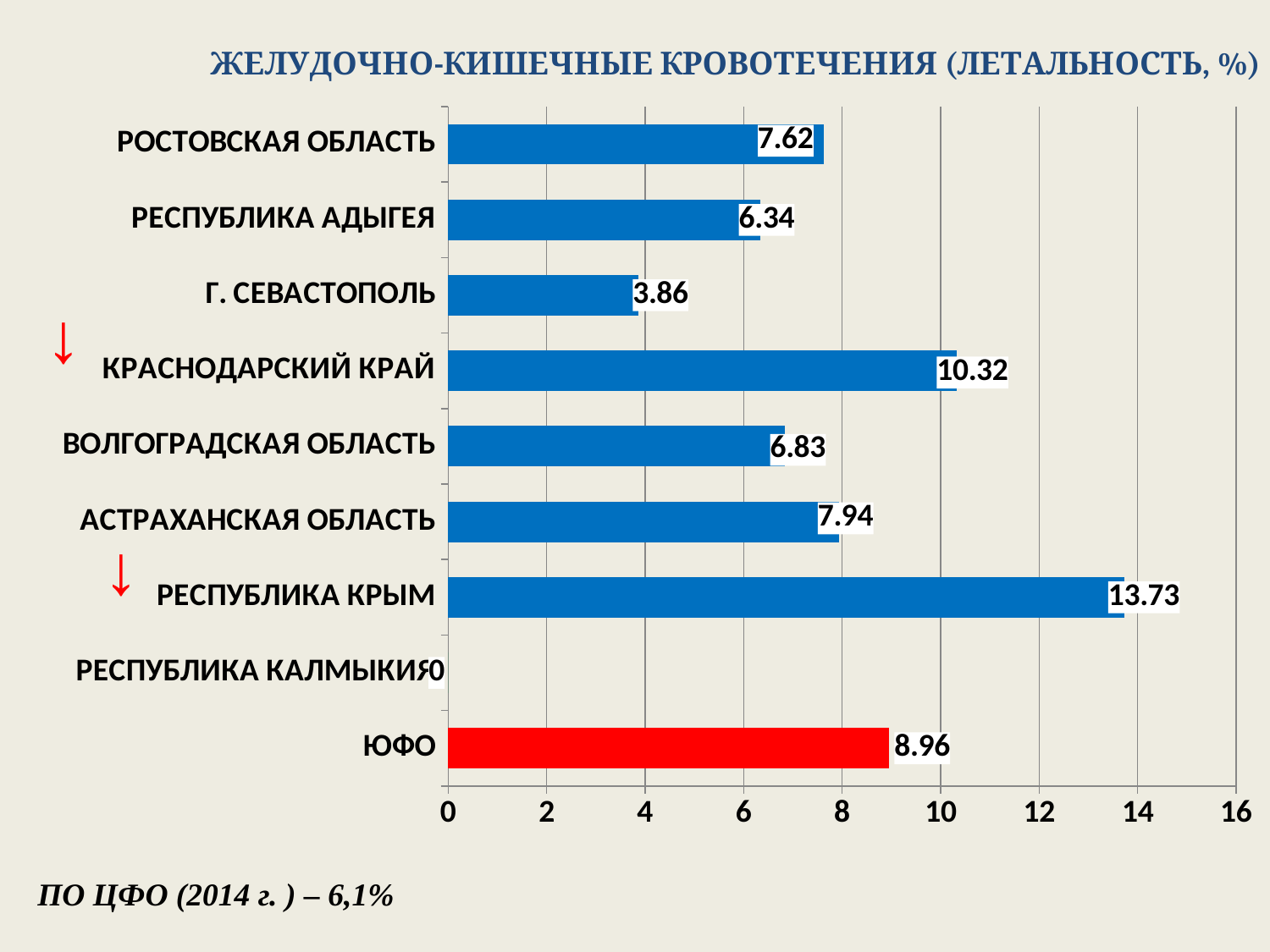
Which category has the highest value? Республика Крым Which category has the lowest value? Республика Калмыкия Is the value for Г. Севастополь greater or less than 4? less What is the value for Республика Калмыкия? 0 What is the value for ЮФО? 8.96 Which is larger, the value for Ростовская область or the value for Астраханская область? Астраханская область What is the value for Краснодарский край? 10.32 How many categories are shown on the chart? 9 What kind of chart is shown on the slide? bar chart What is the title of the chart? ЖЕЛУДОЧНО-КИШЕЧНЫЕ КРОВОТЕЧЕНИЯ (ЛЕТАЛЬНОСТЬ, %) What is the difference between the values for Республика Крым and Краснодарский край? 3.41 Which category's bar is coloured red? ЮФО